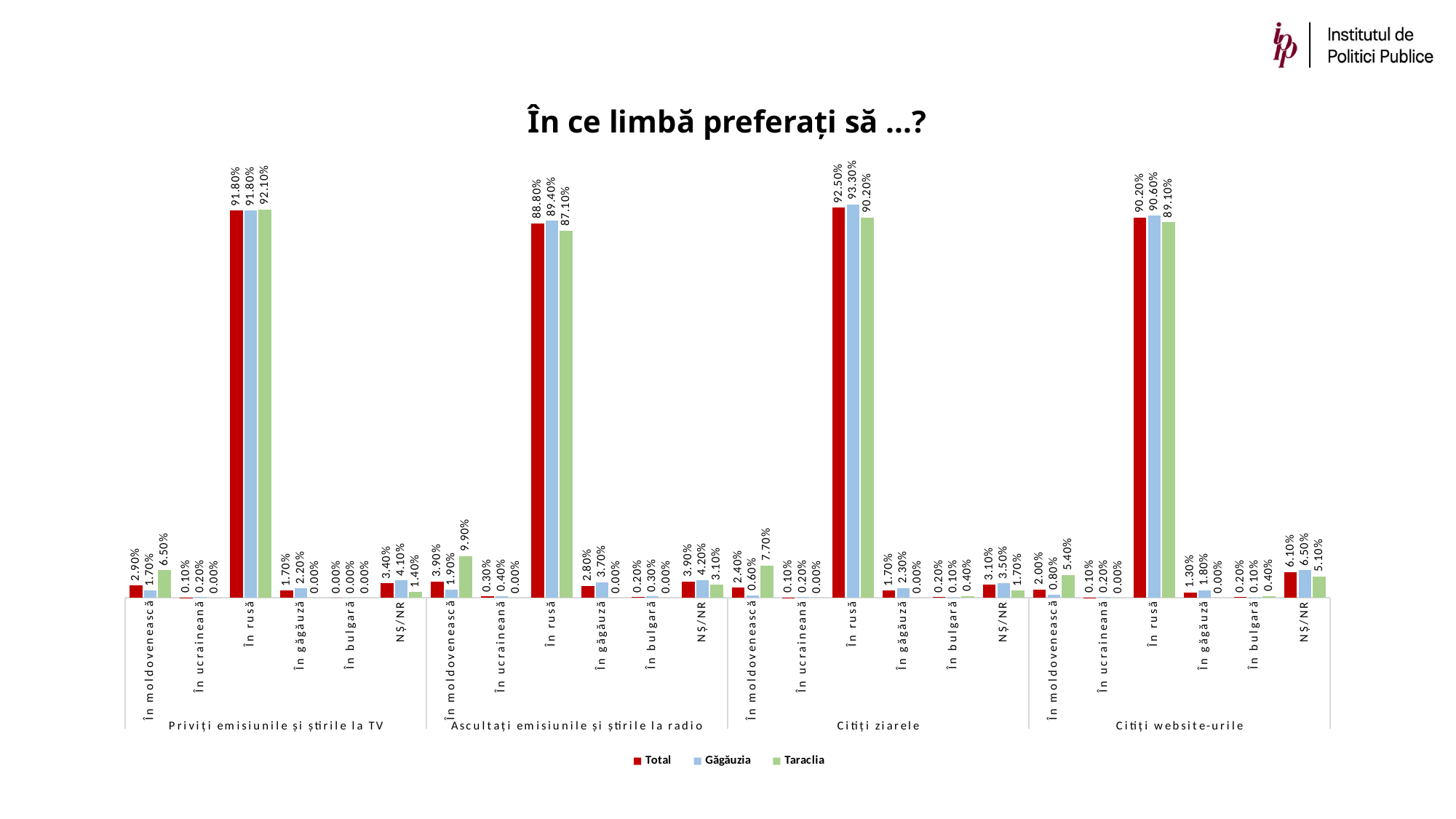
Which series is shown in red in the legend? Total What is the Total value for "În rusă" in the "Priviți emisiunile și știrile la TV" group? 91.80% Which language category has the highest Total value in the "Citiți website-urile" group? În rusă How many language categories are shown within each question group? 6 In the "Ascultați emisiunile și știrile la radio" group, which is larger for "În rusă": the Găgăuzia value or the Taraclia value? Găgăuzia What kind of chart is shown on the slide? Bar chart What is the difference between the Taraclia and Găgăuzia values for "În moldovenească" in the "Citiți ziarele" group? 7.10% What is the Taraclia value for "În moldovenească" in the "Ascultați emisiunile și știrile la radio" group? 9.90% What is the Găgăuzia value for "În rusă" in the "Citiți ziarele" group? 93.30% What is the title of the chart? În ce limbă preferați să ...? What is the Total value for "NȘ/NR" in the "Citiți website-urile" group? 6.10% How many series does the legend list? 3